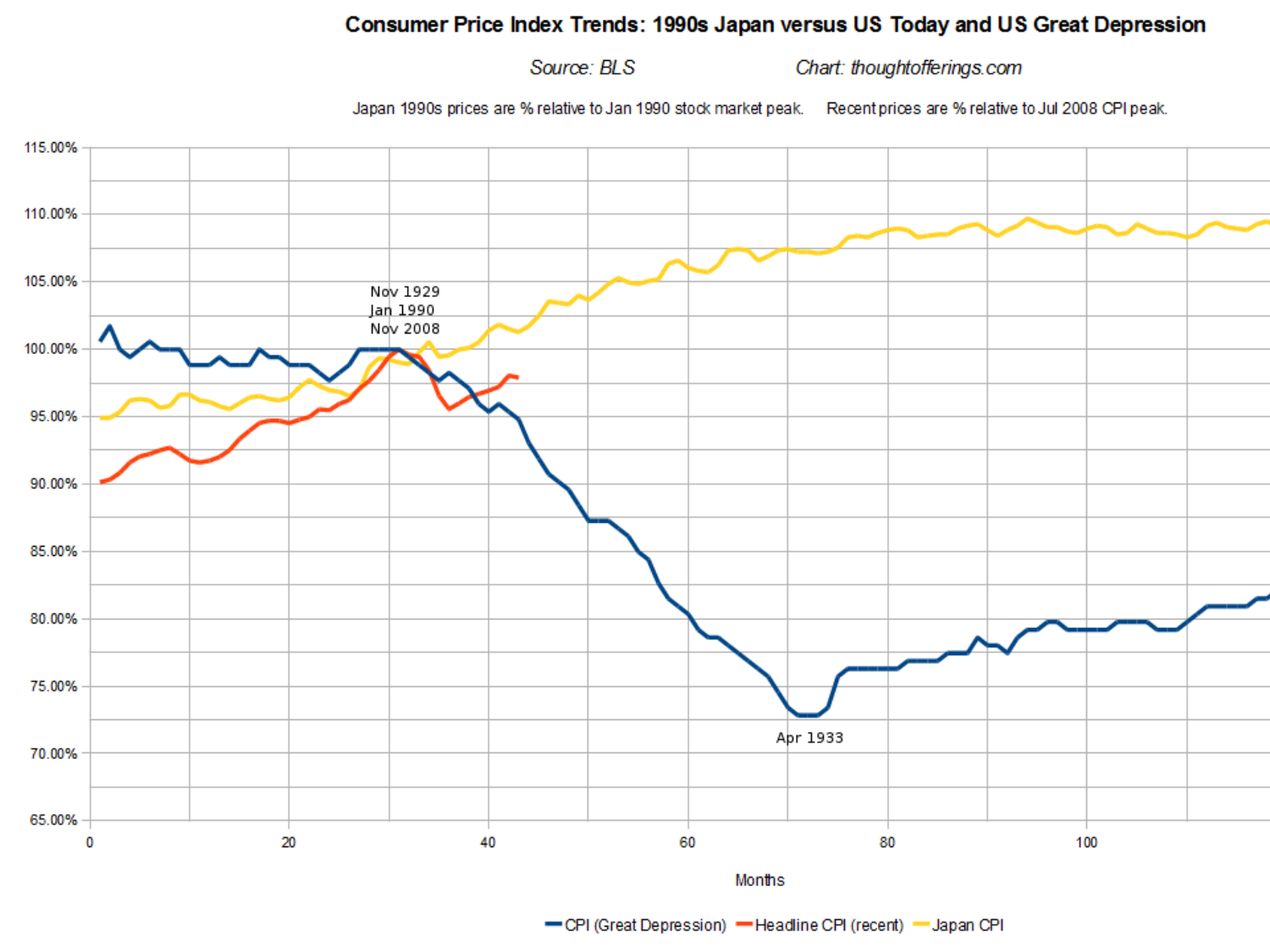
Which series reaches the lowest value on the chart? CPI (Great Depression) At month 80, which series has the larger value: Japan CPI or CPI (Great Depression)? Japan CPI What are the three series named in the legend? CPI (Great Depression), Headline CPI (recent), Japan CPI Which series reaches the highest value on the chart? Japan CPI Is the value of Japan CPI at month 100 greater or less than 105.00%? greater What kind of chart is shown on the slide? line chart What is the label on the x axis? Months Is the value of CPI (Great Depression) at month 60 greater or less than 85.00%? less How many series does the legend list? 3 Does the CPI (Great Depression) line rise or fall between month 30 and month 70? fall Does the Japan CPI line rise or fall between month 40 and month 120? rise Is the value of Headline CPI (recent) at month 1 greater or less than 95.00%? less